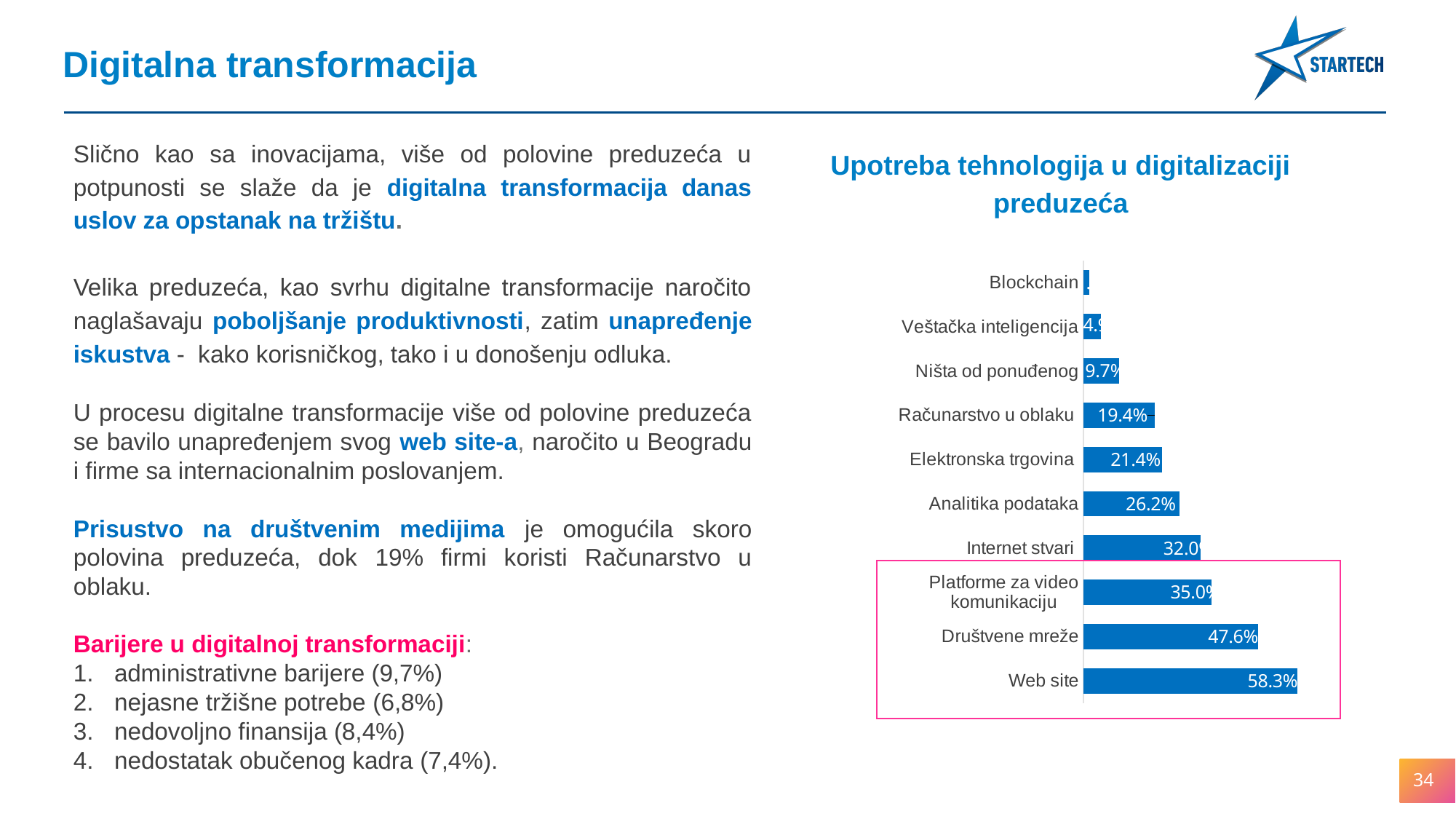
What is the value for Društvene mreže in the chart? 47.6% What is the title of the chart on the slide? Upotreba tehnologija u digitalizaciji preduzeća Which category has the lowest value in the chart? Blockchain How many categories are shown in the chart? 10 What type of chart is shown on the slide? Bar chart What is the value for Analitika podataka in the chart? 26.2% Which is larger, the value for Elektronska trgovina or the value for Analitika podataka? Analitika podataka What is the value for Platforme za video komunikaciju in the chart? 35.0% What is the value for Računarstvo u oblaku in the chart? 19.4% What is the difference between the values for Web site and Društvene mreže? 10.7 percentage points Which category has the highest value in the chart? Web site What is the value for Web site in the chart? 58.3%